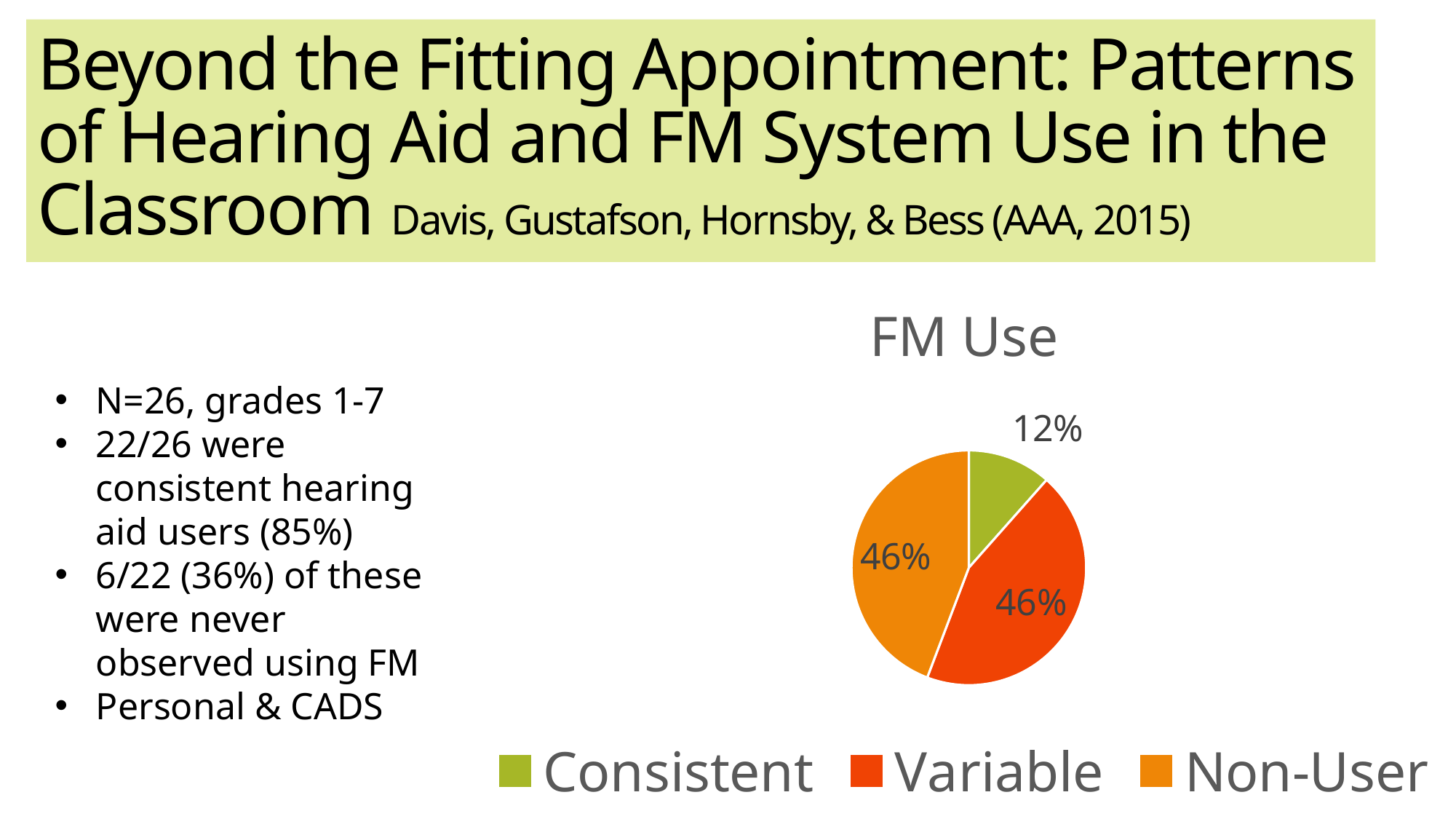
What percentage of the FM Use pie chart is labelled Non-User? 46% What is the title of the pie chart on the slide? FM Use What percentage of the FM Use pie chart is labelled Variable? 46% In the FM Use pie chart, what is the difference in percentage points between the Variable slice and the Consistent slice? 34 How many slices does the FM Use pie chart have? 3 What percentage of the FM Use pie chart is labelled Consistent? 12% Which category has the smallest slice in the FM Use pie chart? Consistent What kind of chart is used to show FM Use? Pie chart What share of the FM Use pie does the Consistent slice represent? 12% Which colour represents the Variable category in the FM Use pie chart? Red In the FM Use pie chart, which slice is larger: Consistent or Non-User? Non-User How many entries does the legend of the FM Use chart list? 3